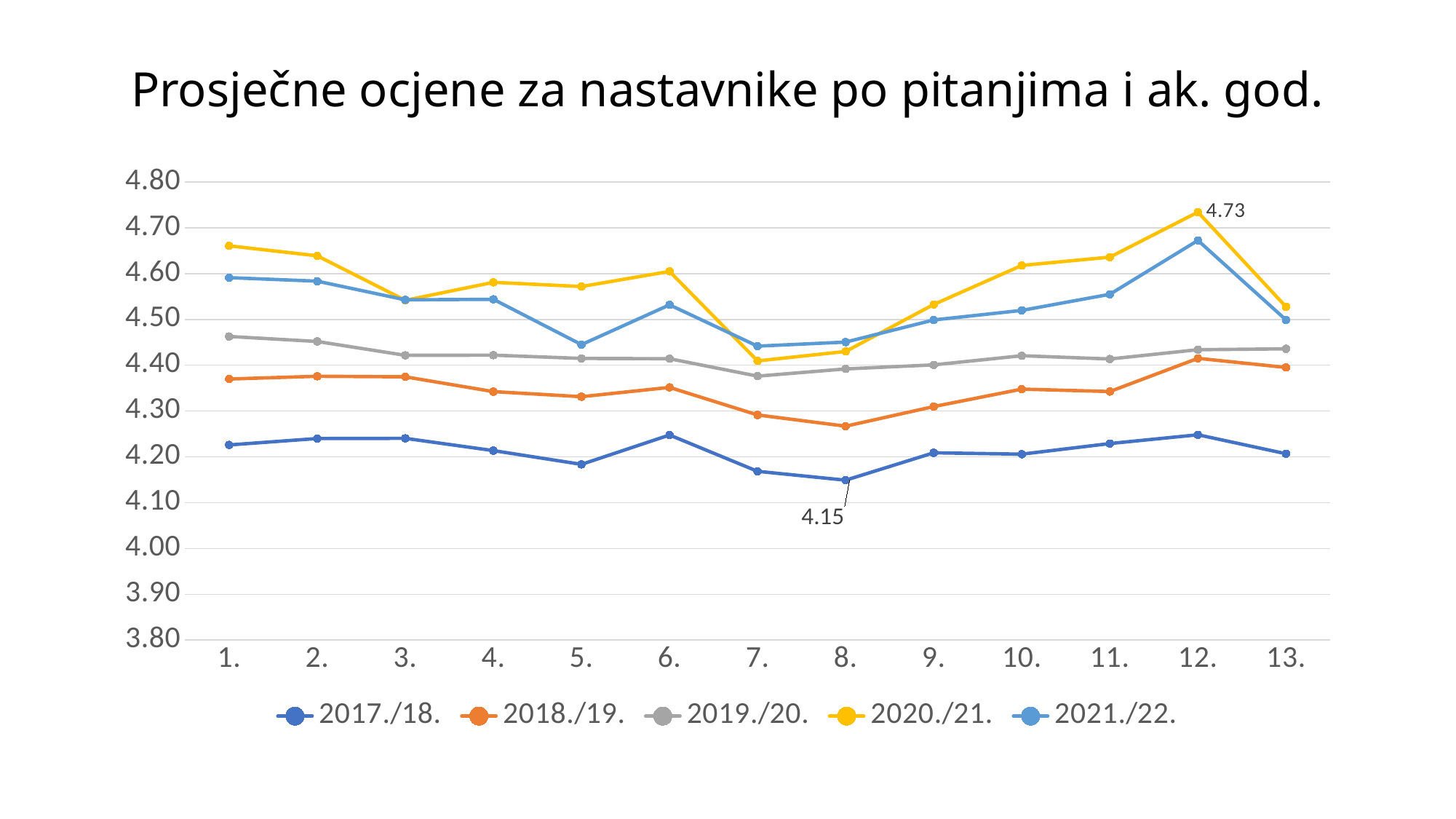
At which question does the 2017./18. series reach its lowest value? 8. At which question does the 2020./21. series reach its highest value? 12. What is the value for 2020./21. at question 12.? 4.73 How many series does the legend list? 5 What kind of chart is shown on the slide? line chart Is the value for 2017./18. at question 1. greater or less than 4.30? less Is the value for 2021./22. at question 12. greater or less than 4.60? greater Does the 2020./21. series rise or fall from question 8. to question 12.? rise At question 5., which series has the higher value: 2020./21. or 2021./22.? 2020./21. How many questions (categories) are shown on the x axis? 13 What is the difference between the labelled value for 2020./21. at question 12. and the labelled value for 2017./18. at question 8.? 0.58 What is the value for 2017./18. at question 8.? 4.15